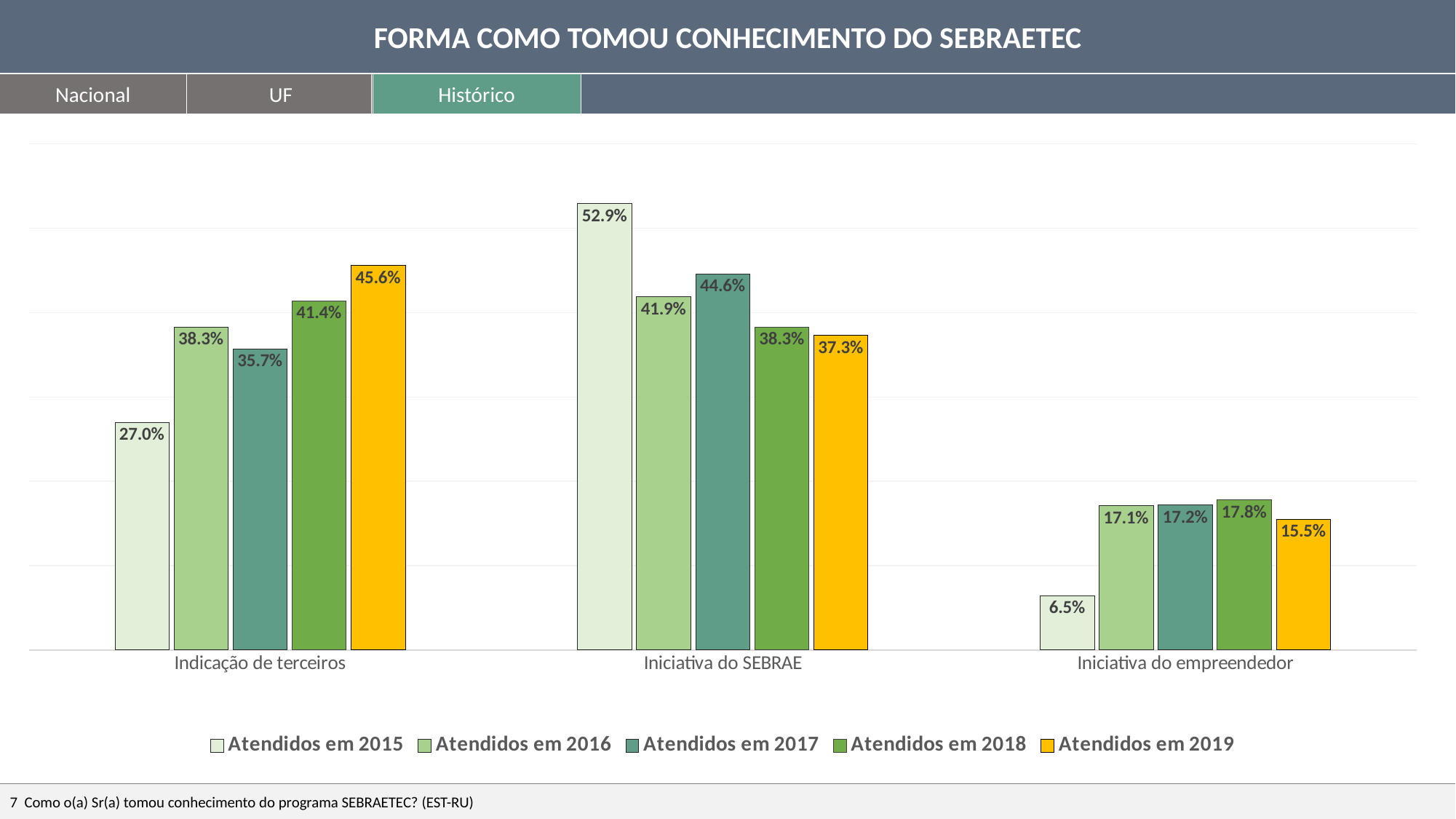
What is the value for 'Atendidos em 2019' in the 'Indicação de terceiros' category? 45.6% What is the title of the chart? FORMA COMO TOMOU CONHECIMENTO DO SEBRAETEC Do the values for 'Atendidos em 2015' rise or fall from 'Indicação de terceiros' to 'Iniciativa do empreendedor'? Rise then fall What is the value for 'Atendidos em 2017' in the 'Iniciativa do empreendedor' category? 17.2% What is the value for 'Atendidos em 2015' in the 'Iniciativa do SEBRAE' category? 52.9% Which series has the highest value in the 'Iniciativa do SEBRAE' category? Atendidos em 2015 How many categories are shown on the x axis? 3 How many series does the legend list? 5 Which series has the lowest value in the 'Indicação de terceiros' category? Atendidos em 2015 Which is larger: 'Atendidos em 2016' for 'Iniciativa do SEBRAE' or 'Atendidos em 2016' for 'Indicação de terceiros'? Iniciativa do SEBRAE What kind of chart is shown on the slide? Bar chart What is the difference between the 'Atendidos em 2019' and 'Atendidos em 2015' values in the 'Indicação de terceiros' category? 18.6%